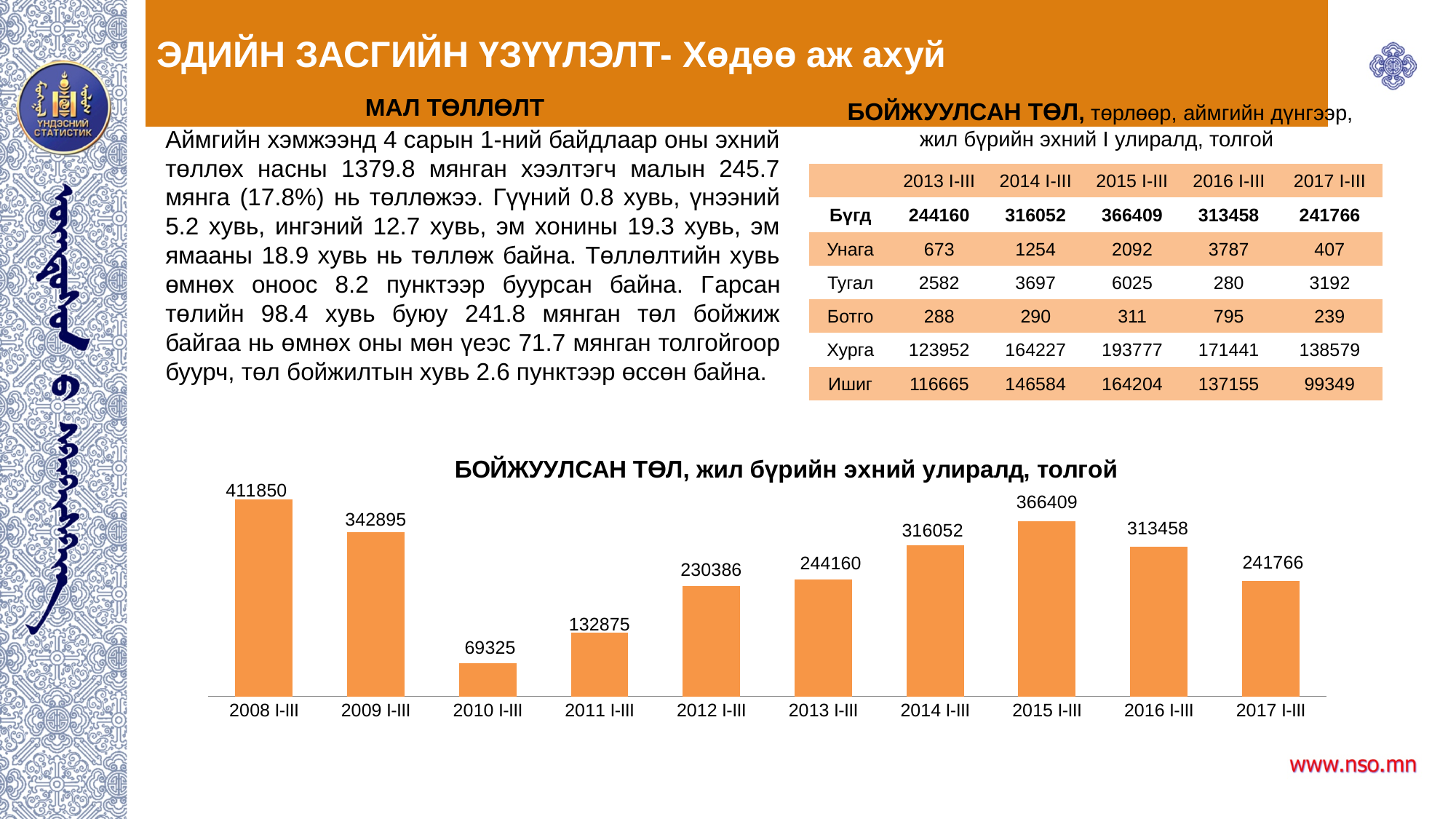
Which period has the lowest value in the chart? 2010 I-III What is the difference between the values for 2011 I-III and 2010 I-III? 63550 What is the value for 2017 I-III in the chart? 241766 Which is larger, the value for 2009 I-III or the value for 2015 I-III? 2015 I-III What is the title of the chart? БОЙЖУУЛСАН ТӨЛ, жил бүрийн эхний улиралд, толгой What type of chart is shown on the slide? bar chart How many bars are plotted in the chart? 10 What is the difference between the values for 2015 I-III and 2016 I-III? 52951 What is the value for 2008 I-III in the chart? 411850 Do the values rise or fall from 2010 I-III to 2015 I-III? rise What is the value for 2012 I-III in the chart? 230386 Which period has the highest value in the chart? 2008 I-III